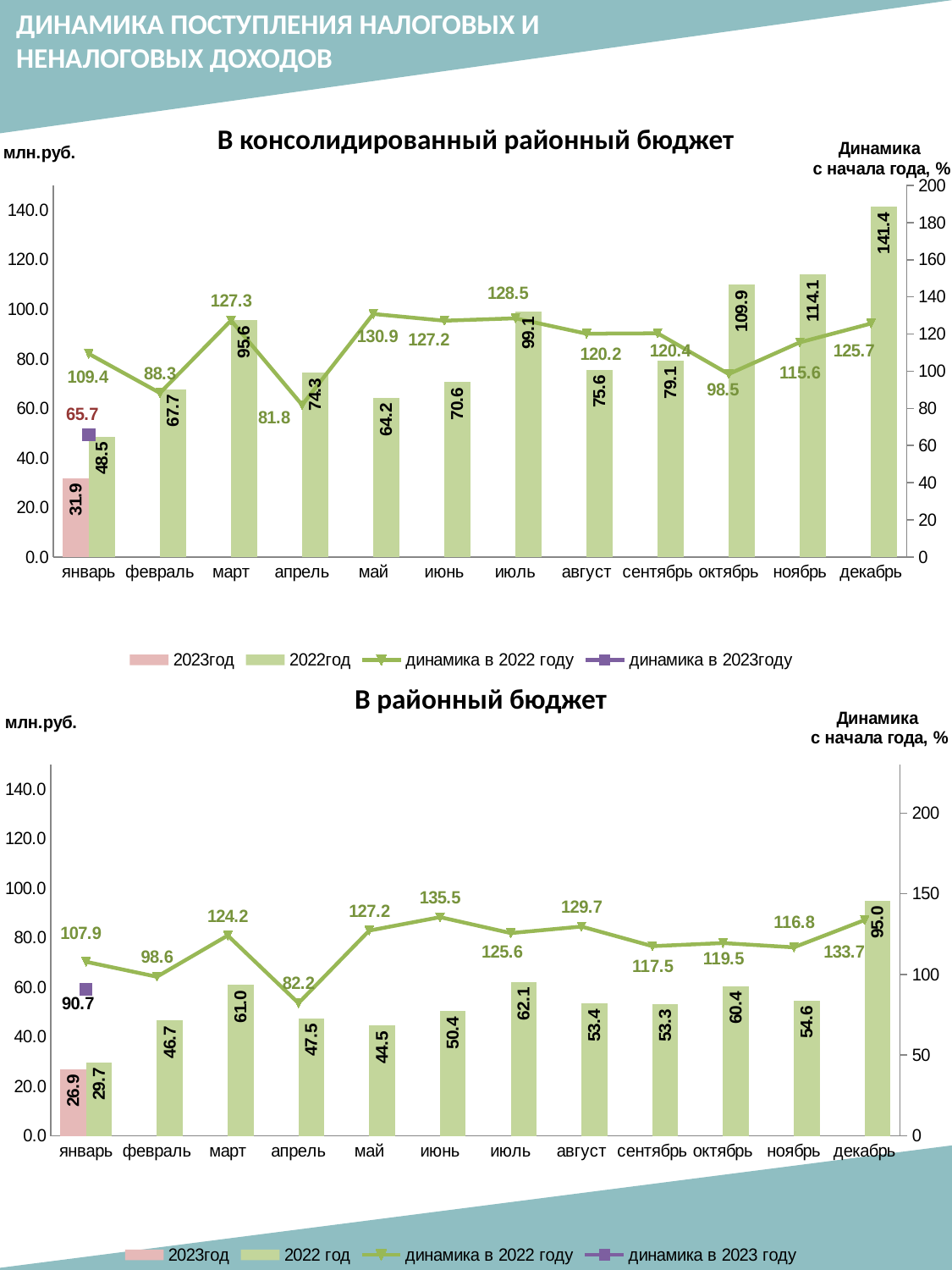
In the chart 'В районный бюджет', how many months are shown on the x axis? 12 In the chart 'В консолидированный районный бюджет', what is the difference between the 2022 год bars for ноябрь and октябрь? 4.2 In the chart 'В районный бюджет', what is the value of the 2022 год bar for июль? 62.1 In the chart 'В районный бюджет', which is larger: the 2022 год bar for март or for апрель? март In the chart 'В консолидированный районный бюджет', what is the value of 'динамика в 2023году' for январь? 65.7 In the chart 'В консолидированный районный бюджет', what is the value of the 2023год bar for январь? 31.9 In the chart 'В консолидированный районный бюджет', how many series does the legend list? 4 In the chart 'В консолидированный районный бюджет', which month has the lowest 2022 год bar? январь In the chart 'В консолидированный районный бюджет', which month has the highest 2022 год bar? декабрь In the chart 'В районный бюджет', which month has the highest 'динамика в 2022 году' value? июнь In the chart 'В консолидированный районный бюджет', what is the value of the 2022 год bar for декабрь? 141.4 What type of chart is 'В районный бюджет'? Combined bar and line chart